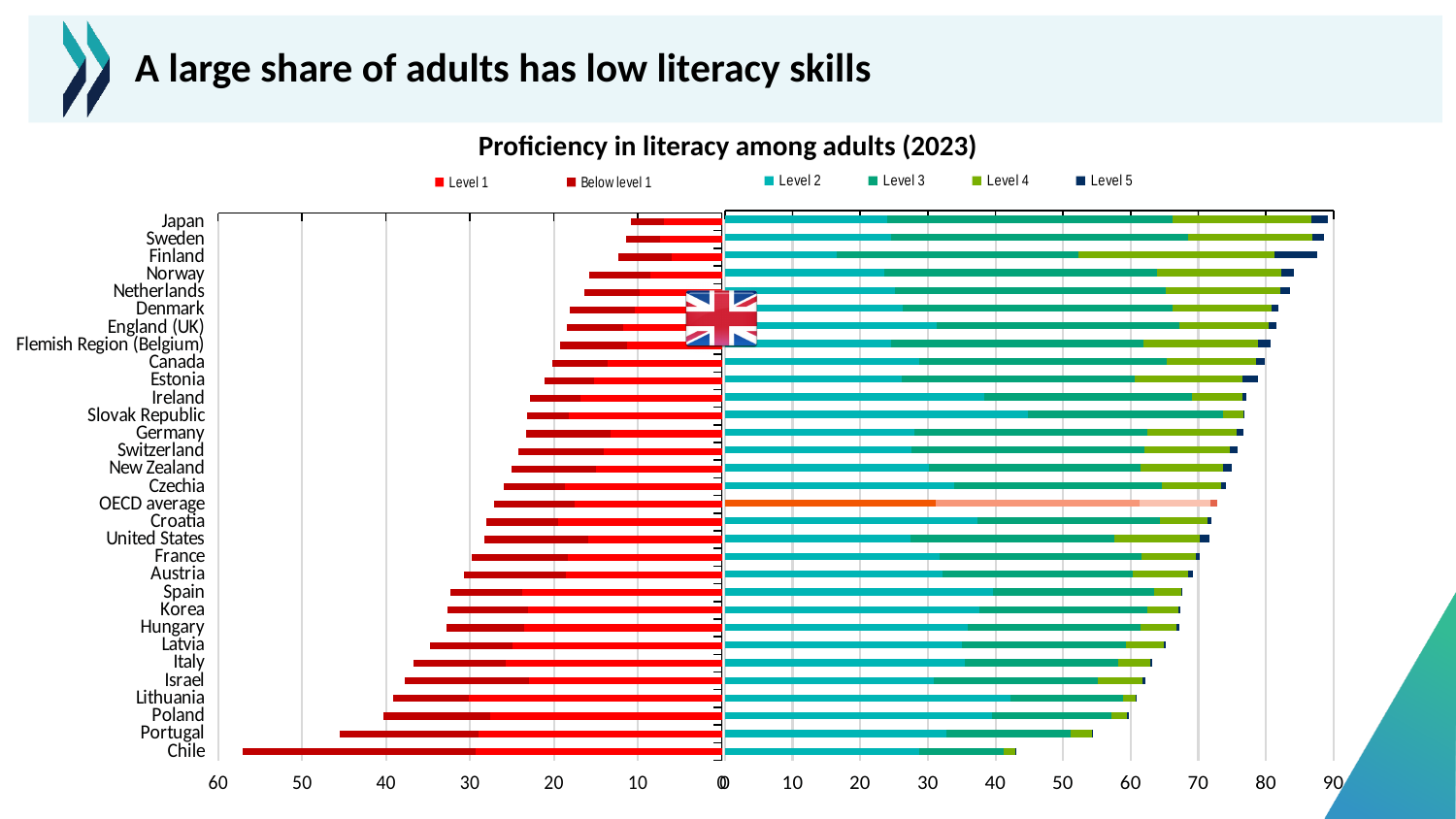
Is the combined Level 1 and Below level 1 value for Chile greater or less than 50? greater Which country has the longest bar on the right side (Level 2 to Level 5 combined)? Japan Is the combined Level 2 to Level 5 value for Chile greater or less than 50? less Which country has the shortest bar on the right side (Level 2 to Level 5 combined)? Chile Going down the chart from Japan to Chile, do the right-side bars (Level 2 to Level 5) generally get longer or shorter? shorter Is the combined Level 2 to Level 5 value for Japan greater or less than 80? greater Which has the longer left-side bar (Level 1 and Below level 1 combined), Portugal or Poland? Portugal How many series does the legend list? 6 Which country has the longest bar on the left side (Level 1 and Below level 1 combined)? Chile What kind of chart is shown on the slide? bar chart How many countries or regions (including the OECD average) are listed on the chart? 31 What is the title of the chart? Proficiency in literacy among adults (2023)